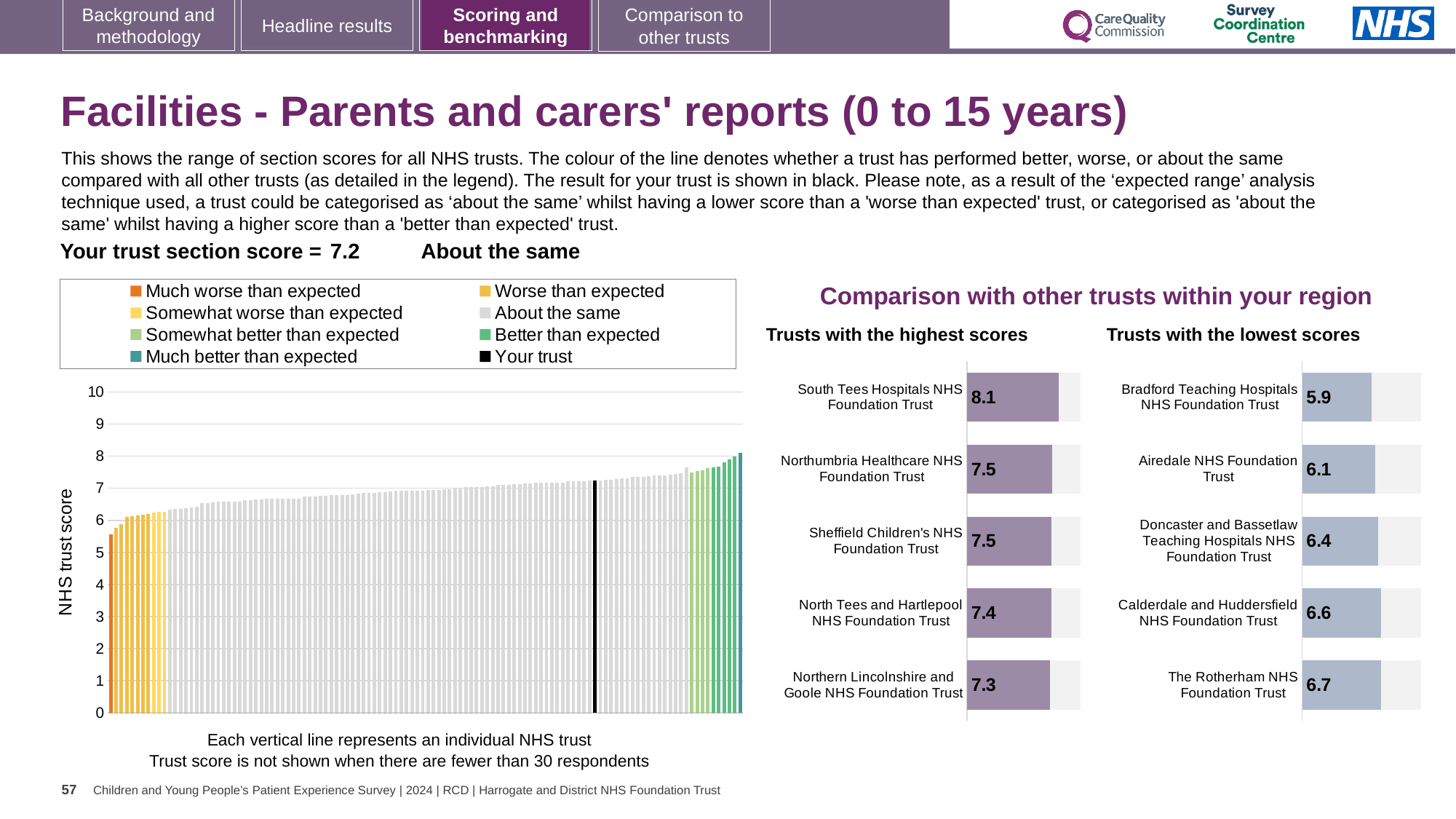
In the 'Trusts with the lowest scores' chart, what is the score for Doncaster and Bassetlaw Teaching Hospitals NHS Foundation Trust? 6.4 How many entries does the legend of the left-hand chart of all NHS trusts list? 8 In the 'Trusts with the highest scores' chart, which trust has the highest score? South Tees Hospitals NHS Foundation Trust In the 'Trusts with the highest scores' chart, what is the score for South Tees Hospitals NHS Foundation Trust? 8.1 In the 'Trusts with the lowest scores' chart, which trust has the lowest score? Bradford Teaching Hospitals NHS Foundation Trust How many trusts are shown in the 'Trusts with the lowest scores' chart? 5 What is the label on the vertical axis of the left-hand chart of all NHS trusts? NHS trust score In the 'Trusts with the lowest scores' chart, which has the larger score: Airedale NHS Foundation Trust or The Rotherham NHS Foundation Trust? The Rotherham NHS Foundation Trust In the left-hand chart of all NHS trusts, do the trust scores rise or fall from left to right along the x axis? Rise In the 'Trusts with the highest scores' chart, what is the difference between the scores of South Tees Hospitals NHS Foundation Trust and Northern Lincolnshire and Goole NHS Foundation Trust? 0.8 In the 'Trusts with the highest scores' chart, what is the score for North Tees and Hartlepool NHS Foundation Trust? 7.4 What kind of chart is the left-hand chart showing the range of section scores for all NHS trusts? Bar chart